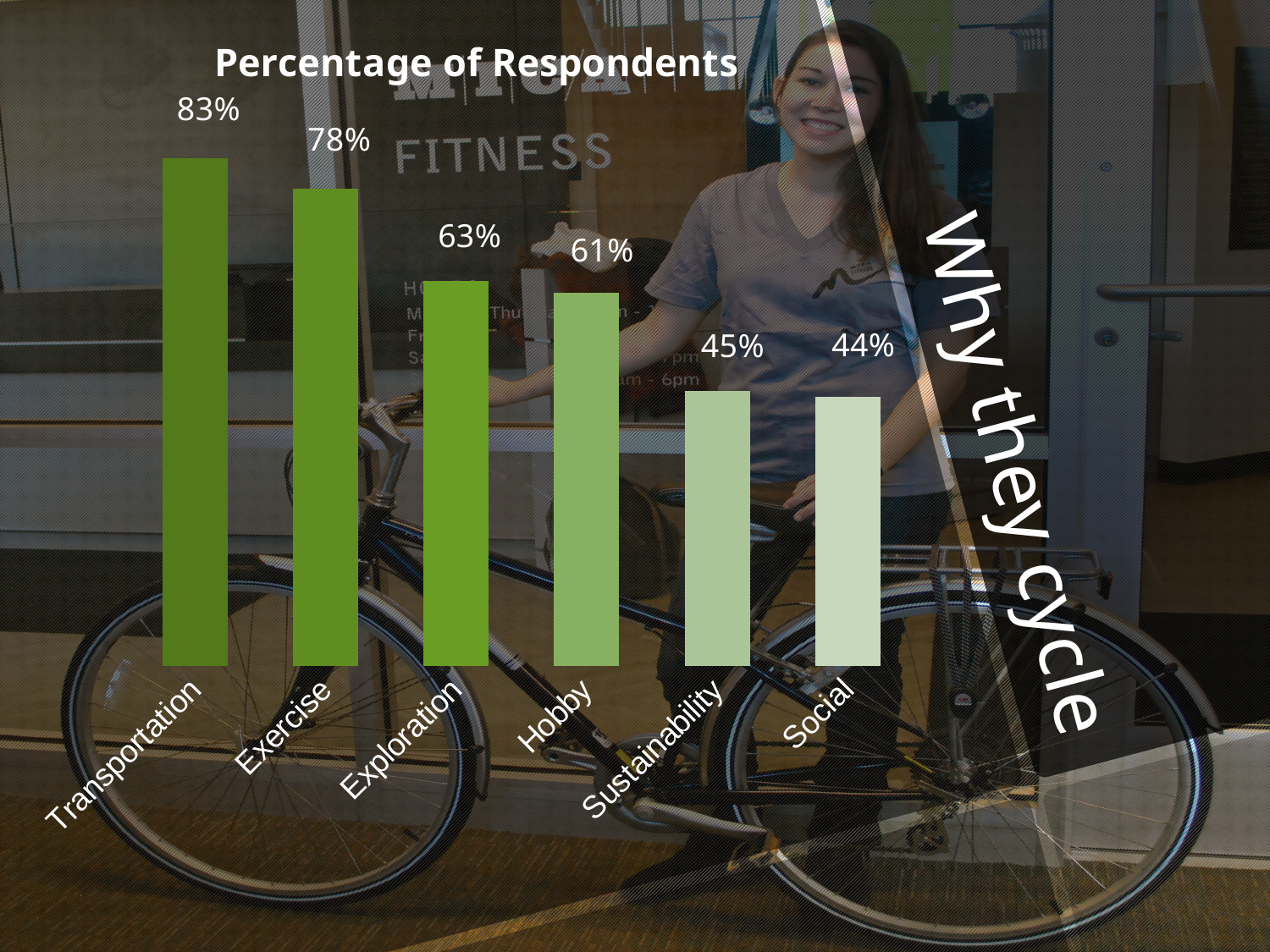
What is the difference between the values for Transportation and Exercise? 5% Which category has the highest percentage of respondents? Transportation Which category has the lowest percentage of respondents? Social What percentage of respondents cite Hobby? 61% Which is larger, the value for Exploration or the value for Sustainability? Exploration What is the difference between the values for Exploration and Social? 19% What is the value for Sustainability? 45% How many categories are shown in the chart? 6 What percentage of respondents cite Transportation as a reason they cycle? 83% What kind of chart is shown on the slide? Bar chart What is the value for Exercise in the chart? 78% What is the title of the chart? Percentage of Respondents